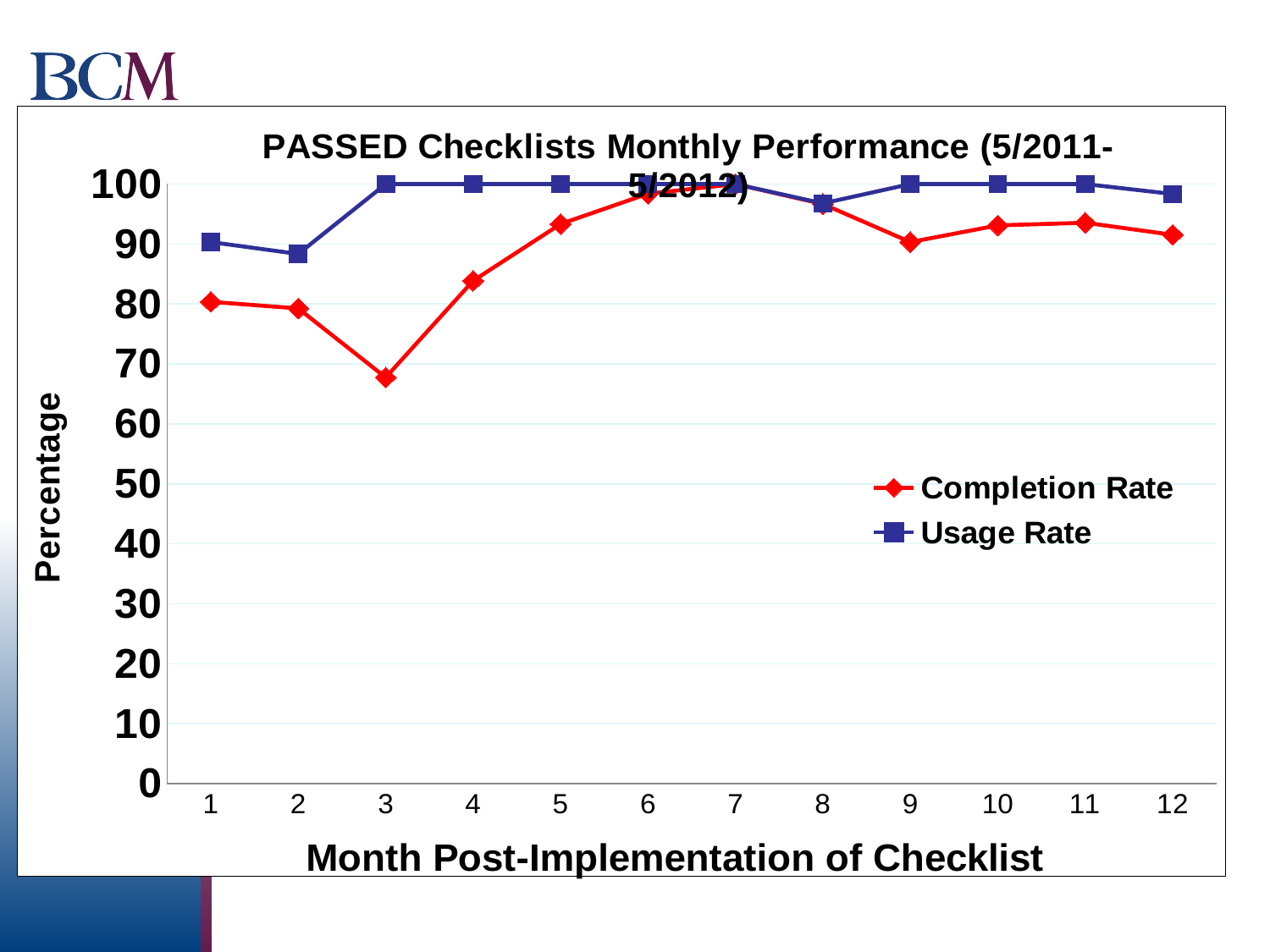
How many months are plotted along the x axis? 12 What is the label of the y axis? Percentage Is the Usage Rate at month 2 greater or less than 80? greater What is the Usage Rate value at month 10? 100 What is the Usage Rate value at month 3? 100 Is the Completion Rate at month 4 greater or less than 80? greater Does the Completion Rate rise or fall from month 3 to month 6? rise Is the Completion Rate at month 3 greater or less than 80? less How many series does the legend list? 2 What kind of chart is shown on the slide? line chart At which month is the Completion Rate lowest? 3 At month 3, which series has the larger value, Completion Rate or Usage Rate? Usage Rate